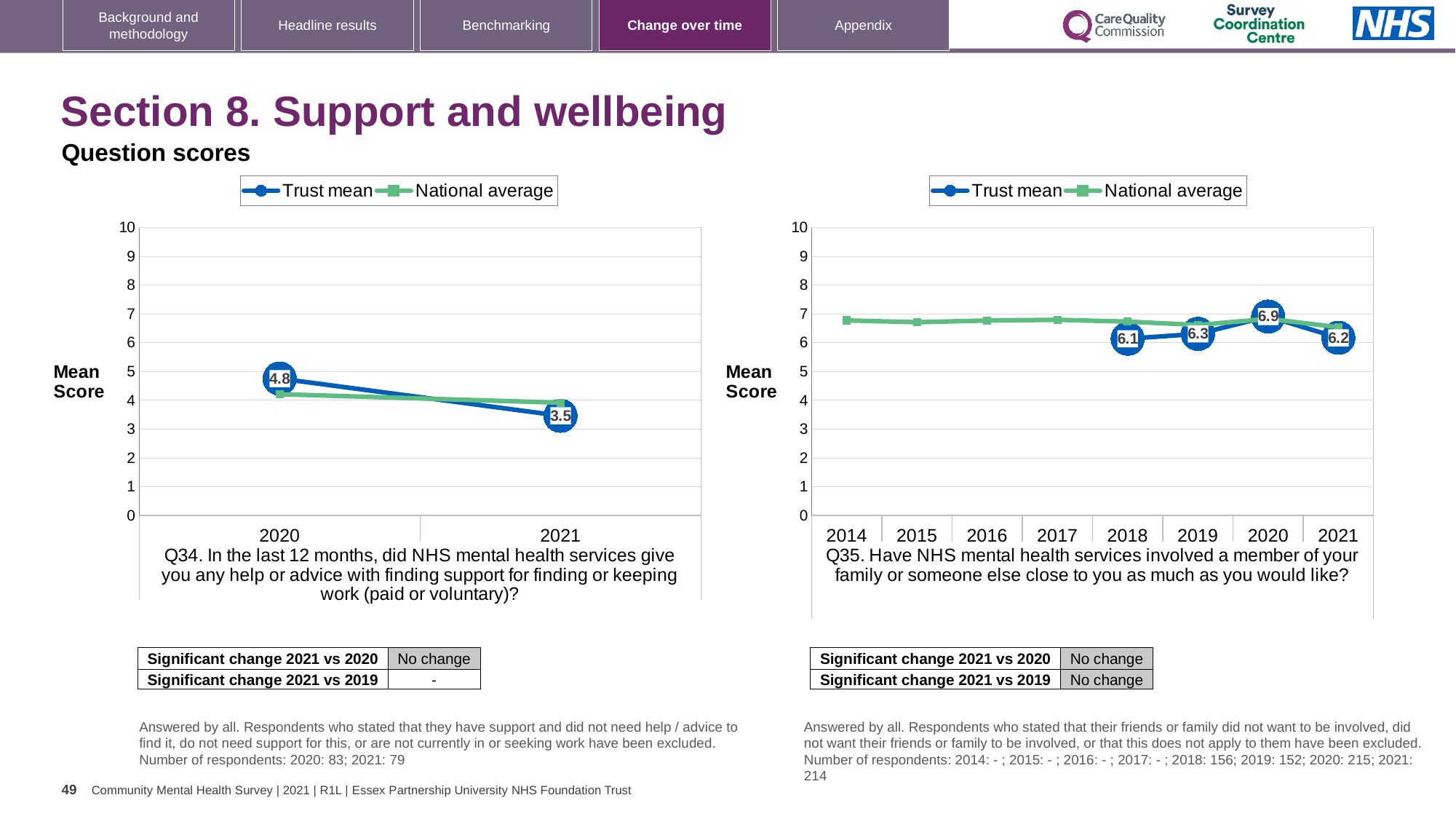
In the Q34 chart on the left, what is the Trust mean for 2020? 4.8 In the Q35 chart on the right, what is the Trust mean for 2018? 6.1 In the Q34 chart on the left, does the Trust mean rise or fall from 2020 to 2021? fall In the Q35 chart on the right, which year has the lowest Trust mean? 2018 In the Q35 chart on the right, what is the Trust mean for 2020? 6.9 In the Q35 chart on the right, which year has the highest Trust mean? 2020 In the Q35 chart on the right, how many years are shown on the x axis? 8 In the Q35 chart on the right, what is the difference between the Trust mean in 2020 and in 2021? 0.7 How many series does the legend of the Q35 chart on the right list? 2 In the Q34 chart on the left, by how much did the Trust mean fall from 2020 to 2021? 1.3 In the Q34 chart on the left, is the National average for 2020 greater or less than 5? less In the Q34 chart on the left, what is the Trust mean for 2021? 3.5